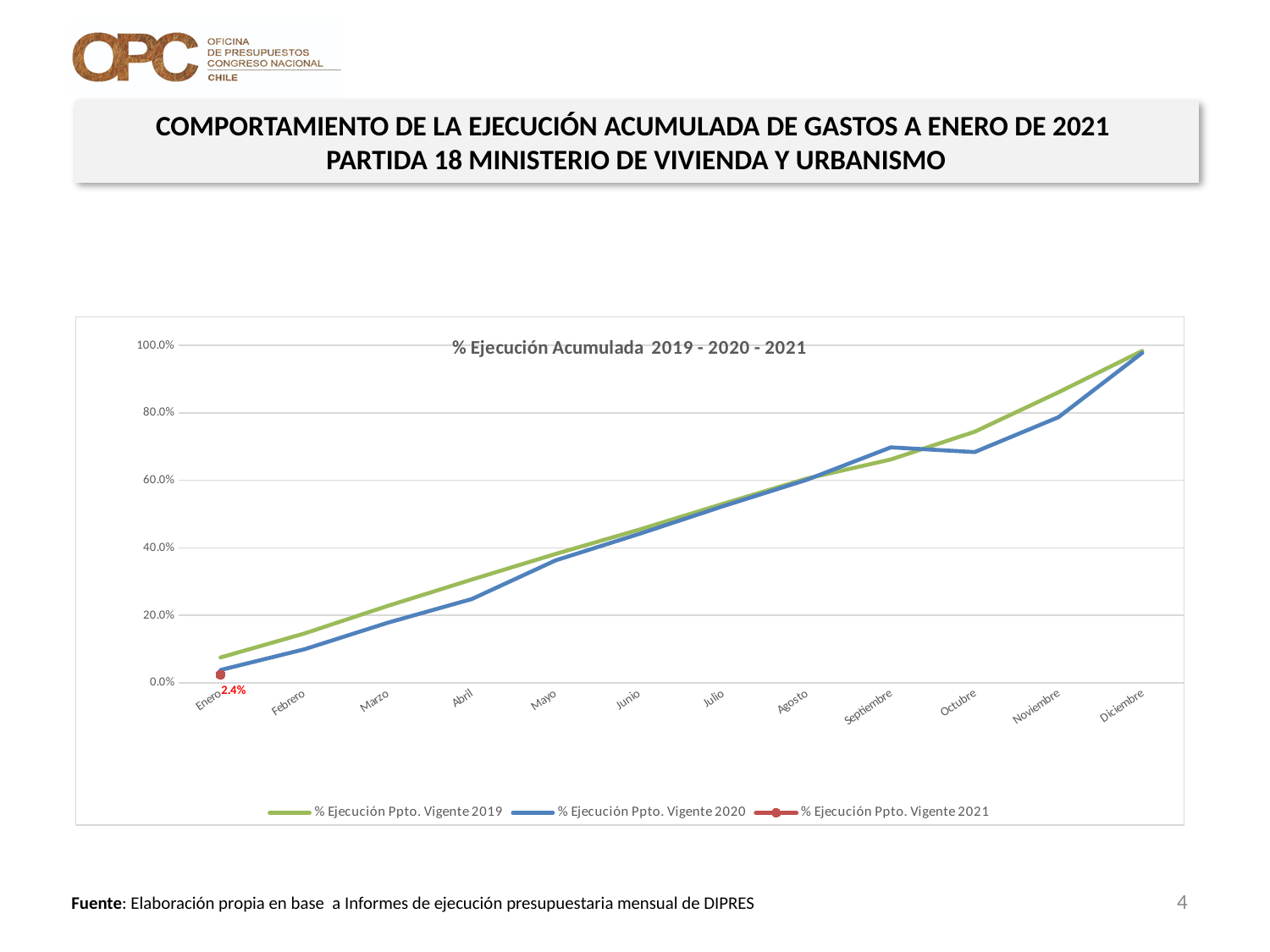
Is the value for Febrero in the % Ejecución Ppto. Vigente 2020 series greater or less than 20.0%? less Do the values of the % Ejecución Ppto. Vigente 2019 series rise or fall from Enero to Diciembre? rise In Abril, which series has the higher value: % Ejecución Ppto. Vigente 2019 or % Ejecución Ppto. Vigente 2020? % Ejecución Ppto. Vigente 2019 In which month does the % Ejecución Ppto. Vigente 2020 series reach its highest value? Diciembre What kind of chart is shown on the slide? line chart In Noviembre, which series has the higher value: % Ejecución Ppto. Vigente 2019 or % Ejecución Ppto. Vigente 2020? % Ejecución Ppto. Vigente 2019 What is the value for Enero in the series % Ejecución Ppto. Vigente 2021? 2.4% Is the value for Octubre in the % Ejecución Ppto. Vigente 2019 series greater or less than 60.0%? greater How many series does the chart legend list? 3 How many months are shown along the x axis of the chart? 12 What is the title of the chart? % Ejecución Acumulada 2019 - 2020 - 2021 Is the value for Abril in the % Ejecución Ppto. Vigente 2019 series greater or less than 20.0%? greater